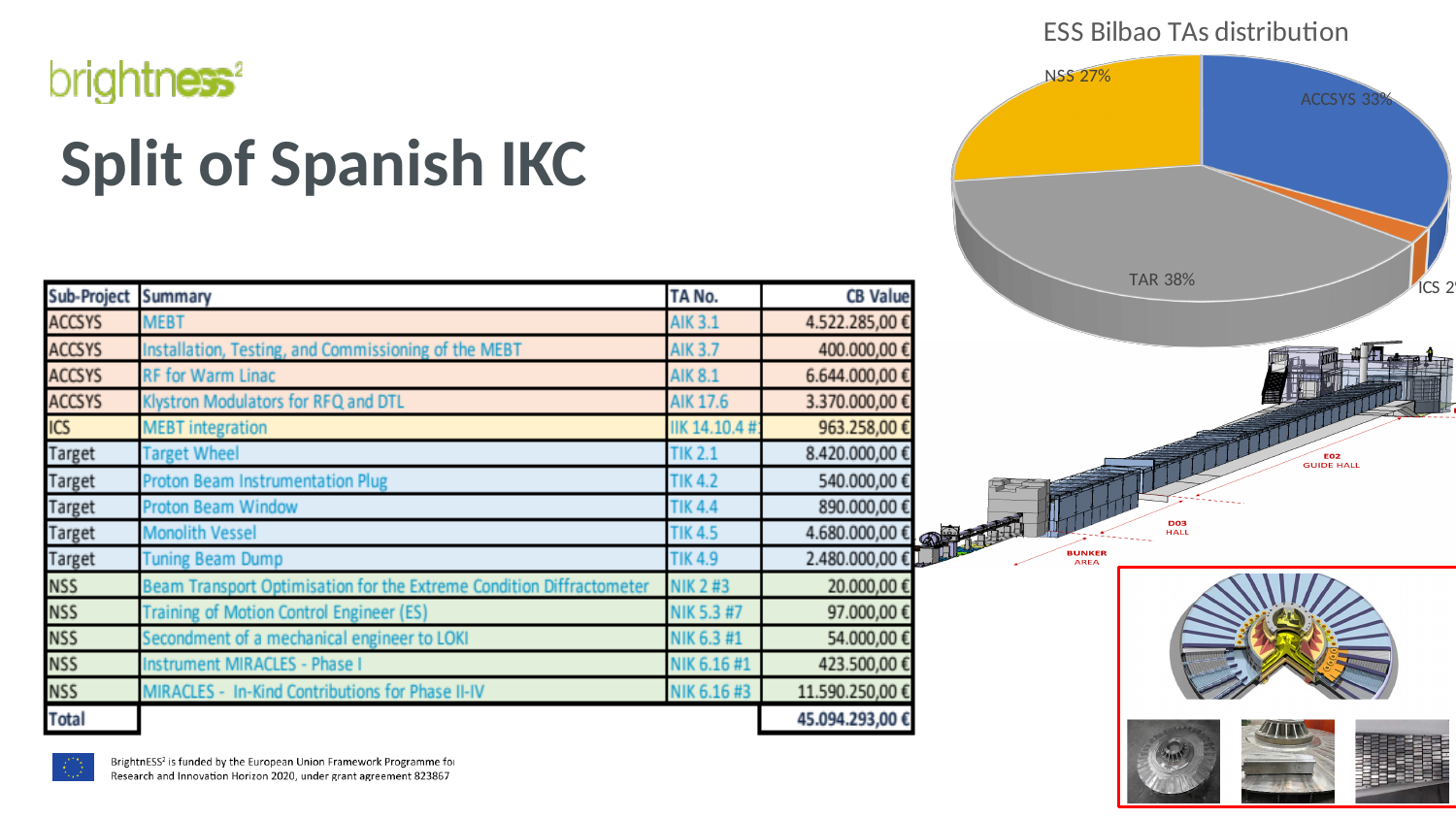
In the ESS Bilbao TAs distribution pie chart, what percentage is shown for ACCSYS? 33% In the ESS Bilbao TAs distribution pie chart, what is the difference between the ACCSYS and NSS shares? 6% What is the title of the pie chart? ESS Bilbao TAs distribution What kind of chart is shown at the top right of the slide? pie chart In the ESS Bilbao TAs distribution pie chart, what share of the pie does NSS represent? 27% In the ESS Bilbao TAs distribution pie chart, which is larger, ACCSYS or NSS? ACCSYS In the ESS Bilbao TAs distribution pie chart, what percentage is shown for TAR? 38% How many slices does the ESS Bilbao TAs distribution pie chart have? 4 What colour is the TAR slice in the ESS Bilbao TAs distribution pie chart? grey Which slice is the largest in the ESS Bilbao TAs distribution pie chart? TAR In the ESS Bilbao TAs distribution pie chart, how many percentage points larger is TAR than NSS? 11% Which slice is the smallest in the ESS Bilbao TAs distribution pie chart? ICS